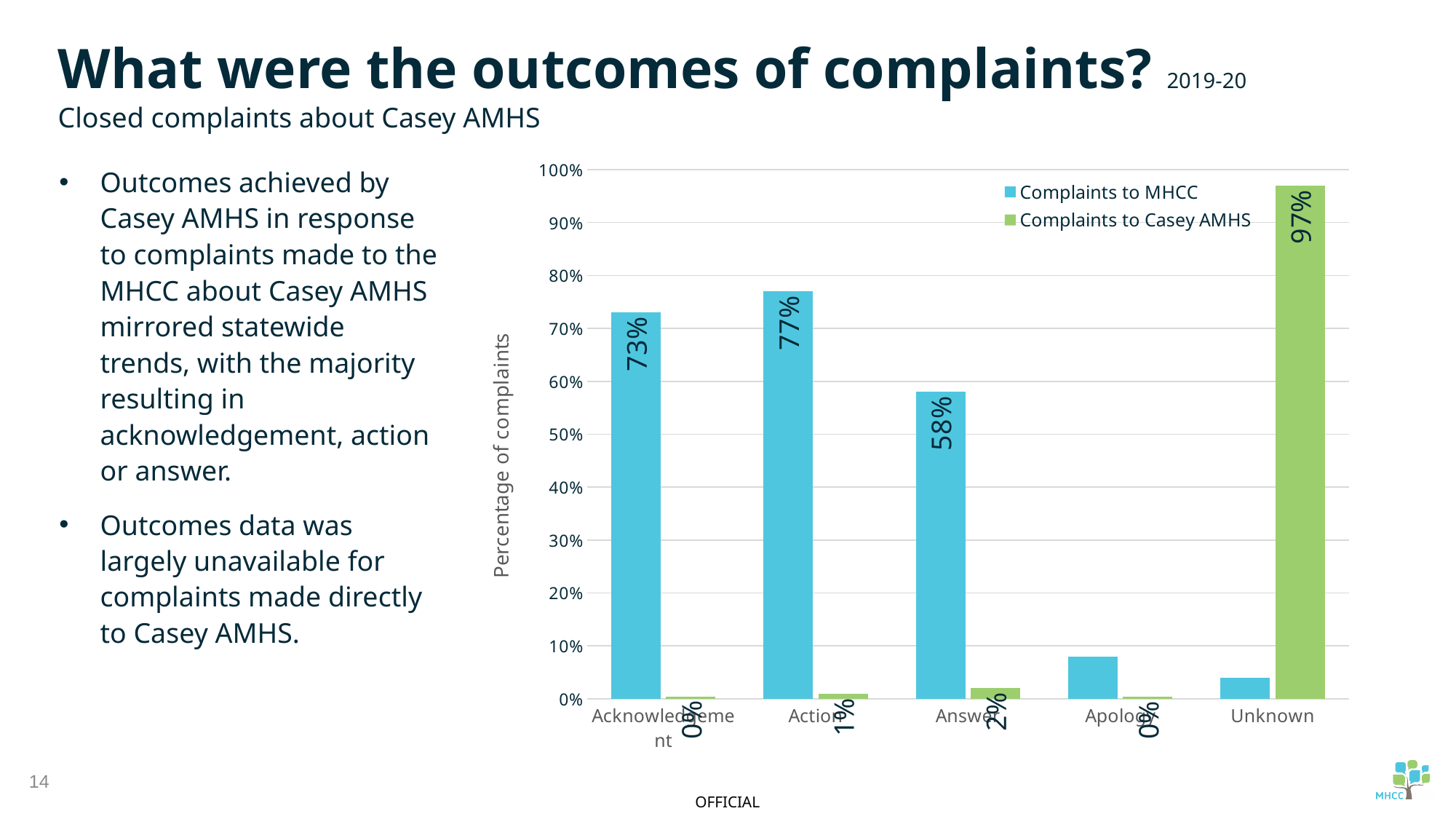
How many series does the chart's legend list? 2 For Complaints to MHCC, which is larger: Acknowledgement or Answer? Acknowledgement What is the value for Complaints to MHCC in the Acknowledgement category? 73% What is the value for Complaints to MHCC in the Action category? 77% Which category has the highest value for Complaints to MHCC? Action Which category has the highest value for Complaints to Casey AMHS? Unknown How many categories are shown on the x axis of the chart? 5 What is the difference between the Complaints to MHCC values for Action and Answer? 19% What kind of chart is shown on the slide? bar chart What is the value for Complaints to Casey AMHS in the Unknown category? 97% What is the value for Complaints to Casey AMHS in the Answer category? 2% Is the value for Complaints to MHCC in the Apology category greater or less than 10%? less